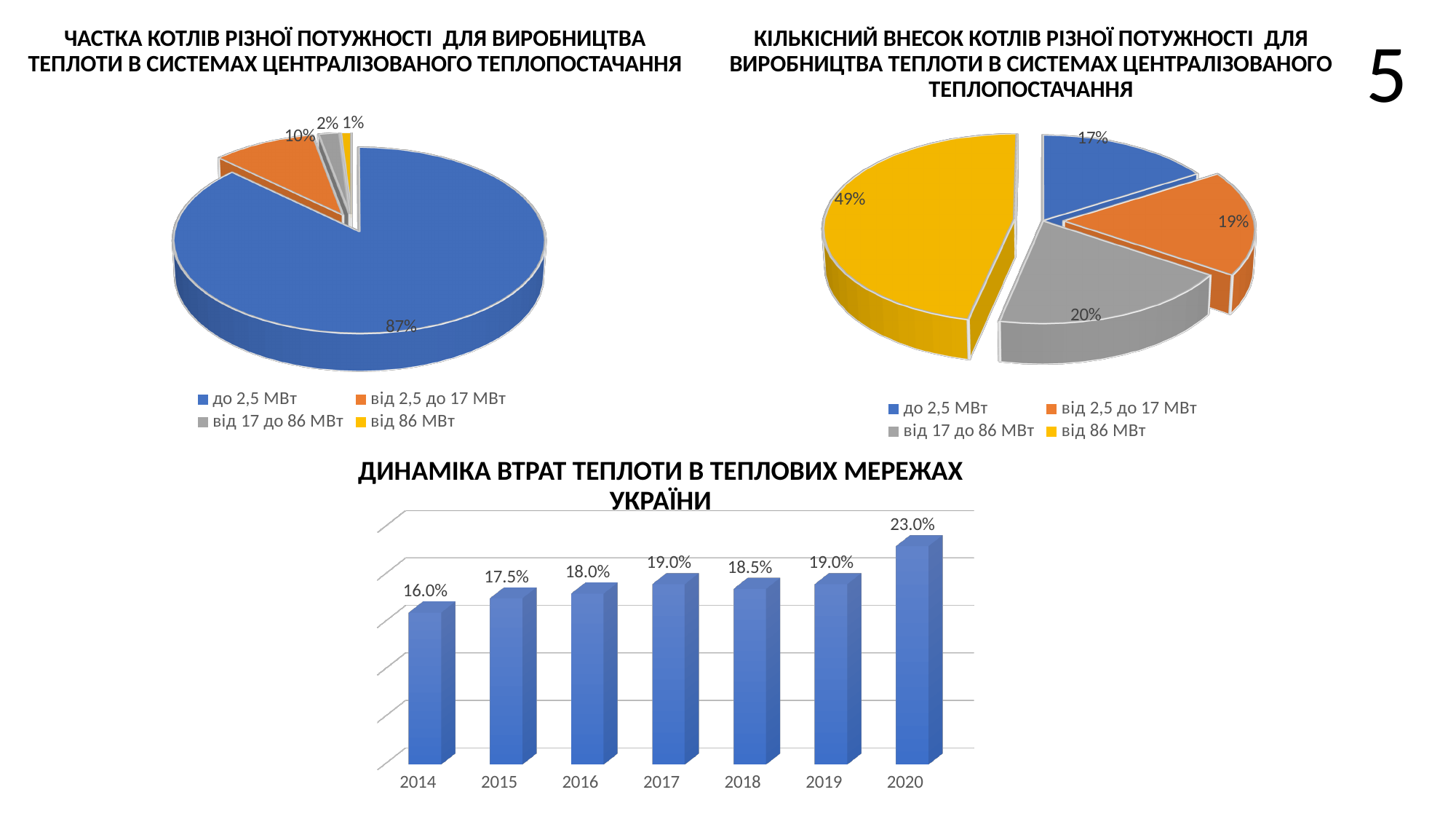
In the right pie chart (КІЛЬКІСНИЙ ВНЕСОК КОТЛІВ), what share is shown for boilers від 86 МВт? 49% In the left pie chart (ЧАСТКА КОТЛІВ РІЗНОЇ ПОТУЖНОСТІ), which category has the smallest share? від 86 МВт In the bottom chart (ДИНАМІКА ВТРАТ ТЕПЛОТИ), what is the value for 2020? 23.0% In the bottom chart (ДИНАМІКА ВТРАТ ТЕПЛОТИ), what is the value for 2014? 16.0% In the left pie chart (ЧАСТКА КОТЛІВ РІЗНОЇ ПОТУЖНОСТІ), what share is shown for boilers від 2,5 до 17 МВт? 10% In the bottom chart (ДИНАМІКА ВТРАТ ТЕПЛОТИ), what is the difference between the values for 2020 and 2014? 7.0% What kind of chart is the bottom chart (ДИНАМІКА ВТРАТ ТЕПЛОТИ)? Bar chart In the left pie chart (ЧАСТКА КОТЛІВ РІЗНОЇ ПОТУЖНОСТІ), what share is shown for boilers до 2,5 МВт? 87% In the bottom chart (ДИНАМІКА ВТРАТ ТЕПЛОТИ), which year has the highest value? 2020 In the right pie chart (КІЛЬКІСНИЙ ВНЕСОК КОТЛІВ), how many categories does the legend list? 4 In the right pie chart (КІЛЬКІСНИЙ ВНЕСОК КОТЛІВ), which category has the largest share? від 86 МВт